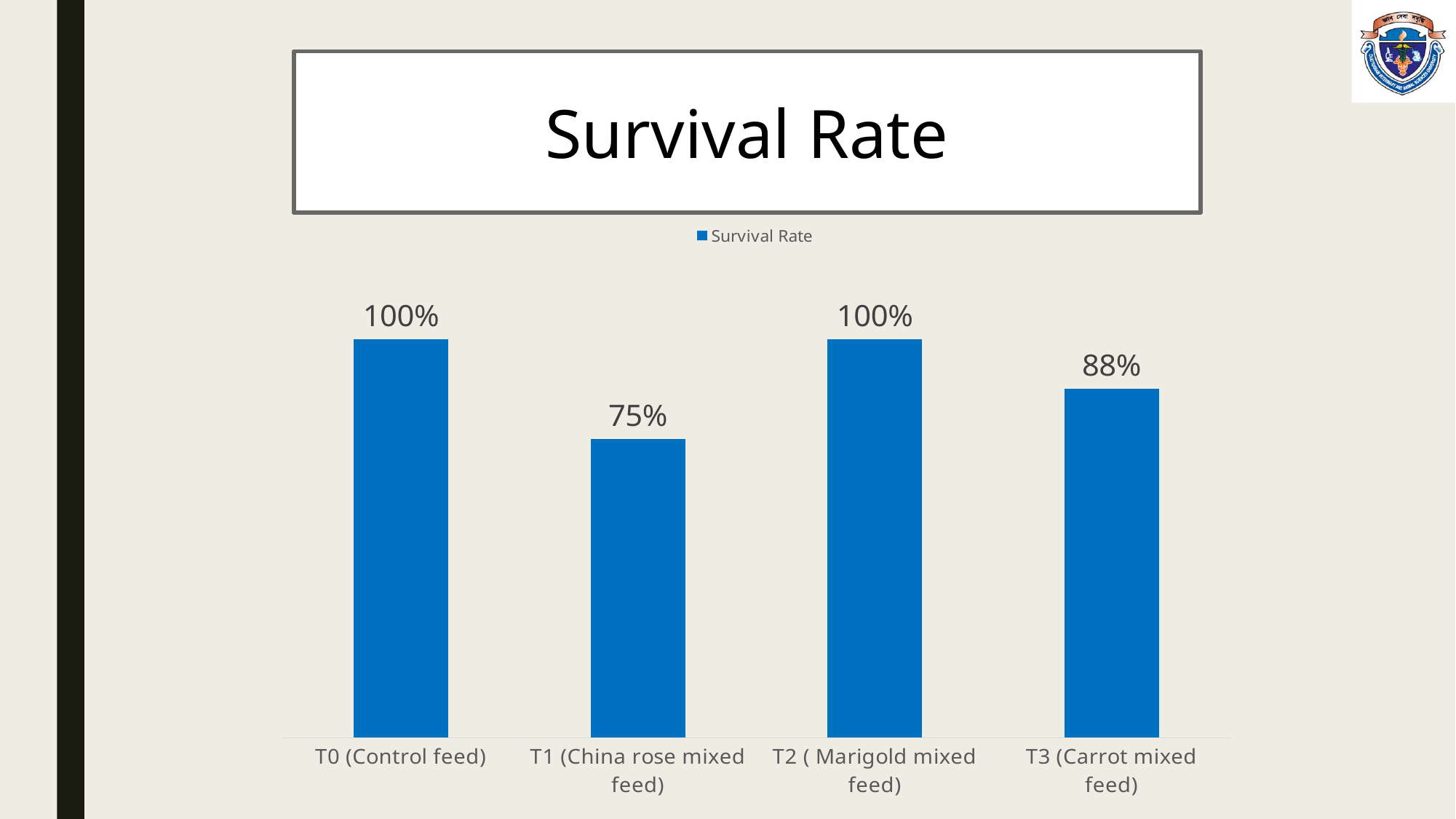
Which has a higher survival rate, T2 (Marigold mixed feed) or T3 (Carrot mixed feed)? T2 (Marigold mixed feed) What kind of chart is shown on the slide? Bar chart What is the survival rate for T1 (China rose mixed feed)? 75% What is the difference in survival rate between T3 (Carrot mixed feed) and T1 (China rose mixed feed)? 13% What is the title of the chart? Survival Rate How many series does the legend list? 1 How many treatment categories are shown in the chart? 4 Which treatment has the lowest survival rate? T1 (China rose mixed feed) What is the survival rate for T3 (Carrot mixed feed)? 88% What is the difference in survival rate between T0 (Control feed) and T1 (China rose mixed feed)? 25% What is the survival rate for T0 (Control feed)? 100% Which has a higher survival rate, T1 (China rose mixed feed) or T3 (Carrot mixed feed)? T3 (Carrot mixed feed)